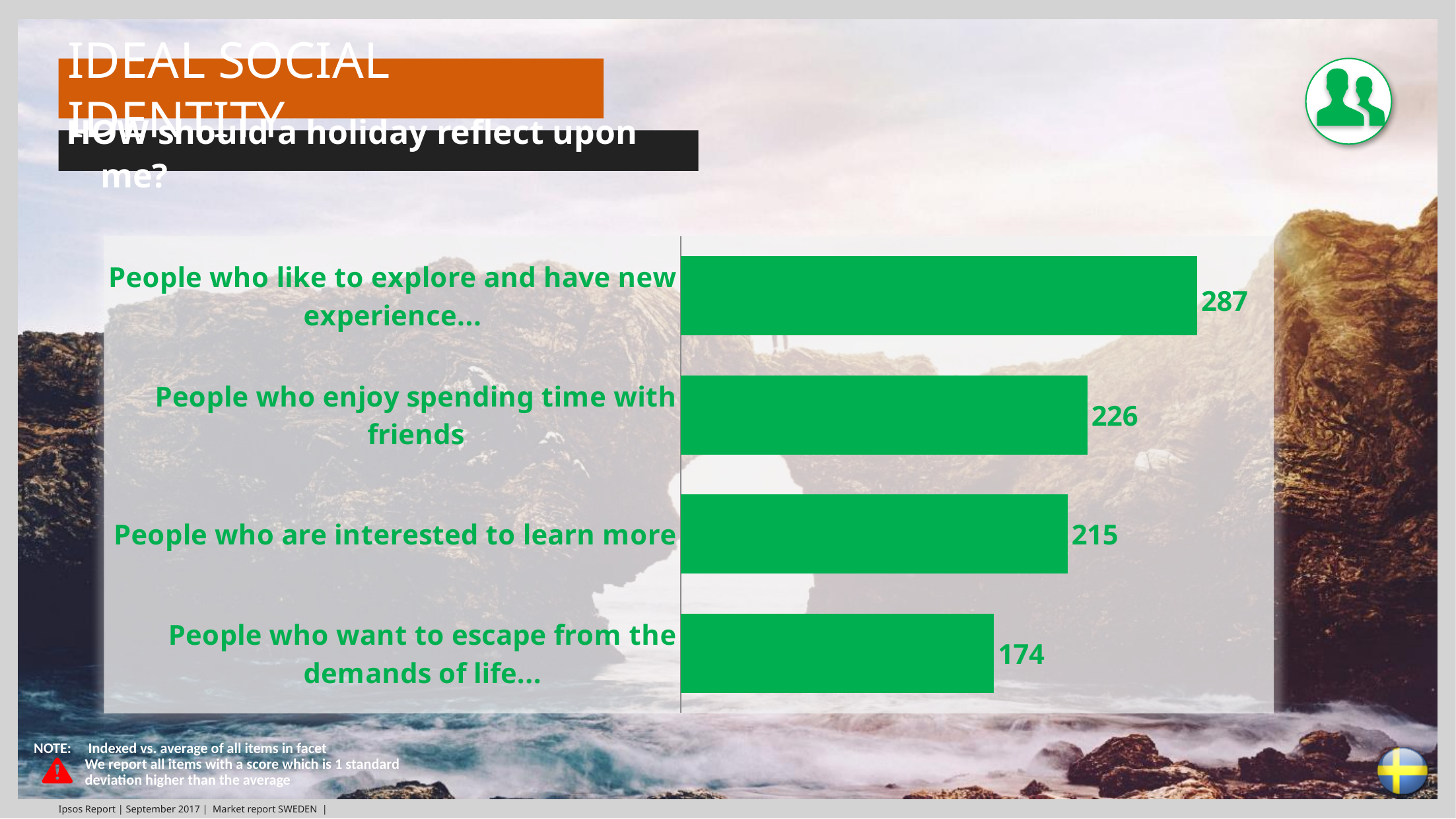
What is the difference between the values for "People who enjoy spending time with friends" and "People who are interested to learn more"? 11 What is the value for "People who are interested to learn more"? 215 What colour are the bars in the chart? Green What is the value for "People who want to escape from the demands of life..."? 174 What is the value for "People who enjoy spending time with friends"? 226 Which is larger: the value for "People who enjoy spending time with friends" or for "People who want to escape from the demands of life..."? People who enjoy spending time with friends How many categories are shown in the chart? 4 What kind of chart is shown on the slide? Bar chart What is the value for "People who like to explore and have new experience..."? 287 What is the difference between the values for "People who like to explore and have new experience..." and "People who want to escape from the demands of life..."? 113 Which category has the lowest value? People who want to escape from the demands of life... Which category has the highest value? People who like to explore and have new experience...